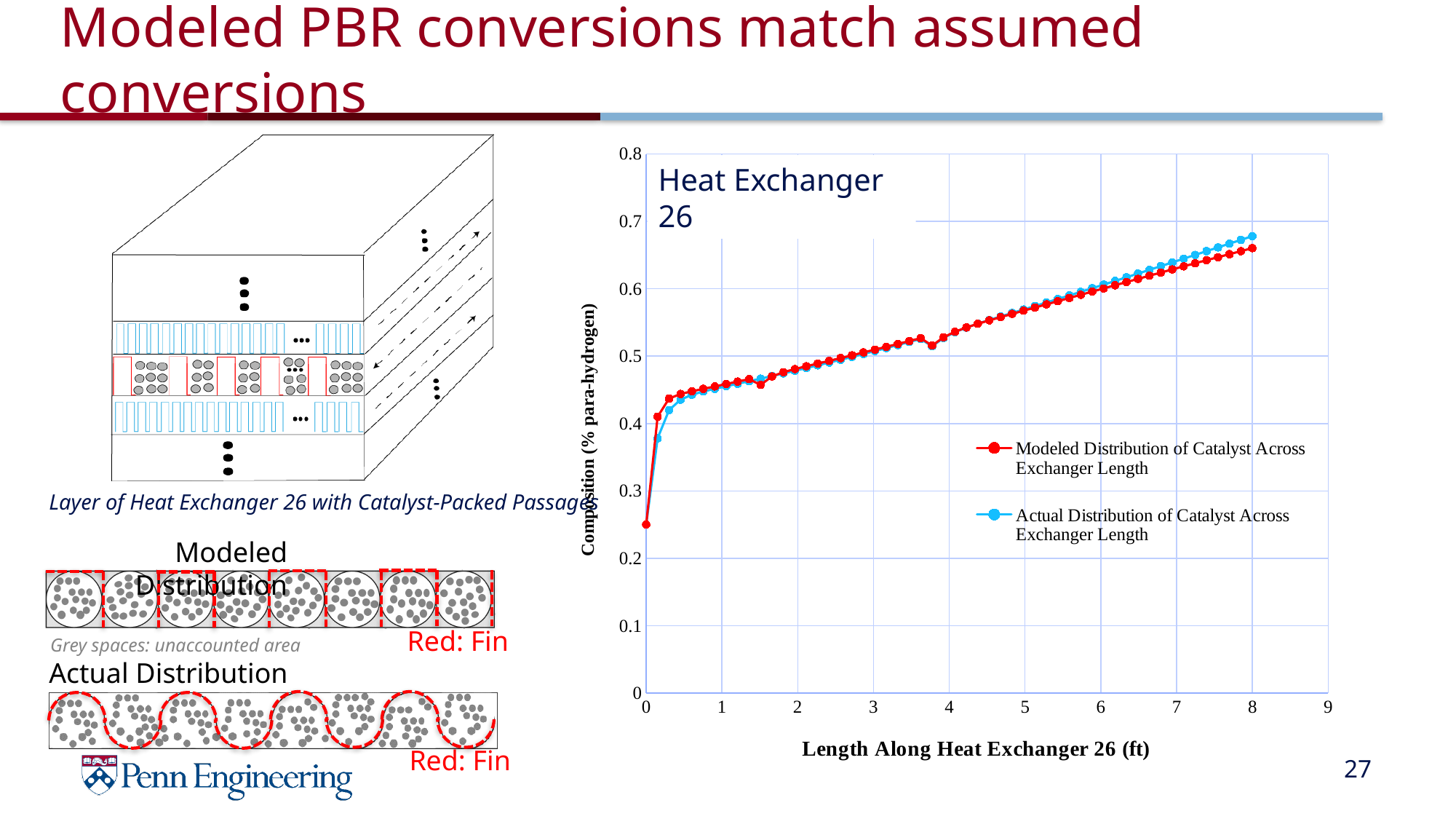
Is the composition value for the Modeled Distribution at a length of 4 ft greater or less than 0.5? greater Is the composition value for the Modeled Distribution at a length of 8 ft greater or less than 0.6? greater How many series does the chart legend list? 2 What is the title of the x axis of the chart? Length Along Heat Exchanger 26 (ft) Do the plotted composition values rise or fall as the length along Heat Exchanger 26 increases? rise Is the composition value at a length of 0 ft greater or less than 0.3? less What colour is used for the Modeled Distribution of Catalyst Across Exchanger Length series? red At a length of 8 ft, which series has the higher composition value: the Modeled Distribution or the Actual Distribution? Actual Distribution of Catalyst Across Exchanger Length What kind of chart is shown on the slide? line chart